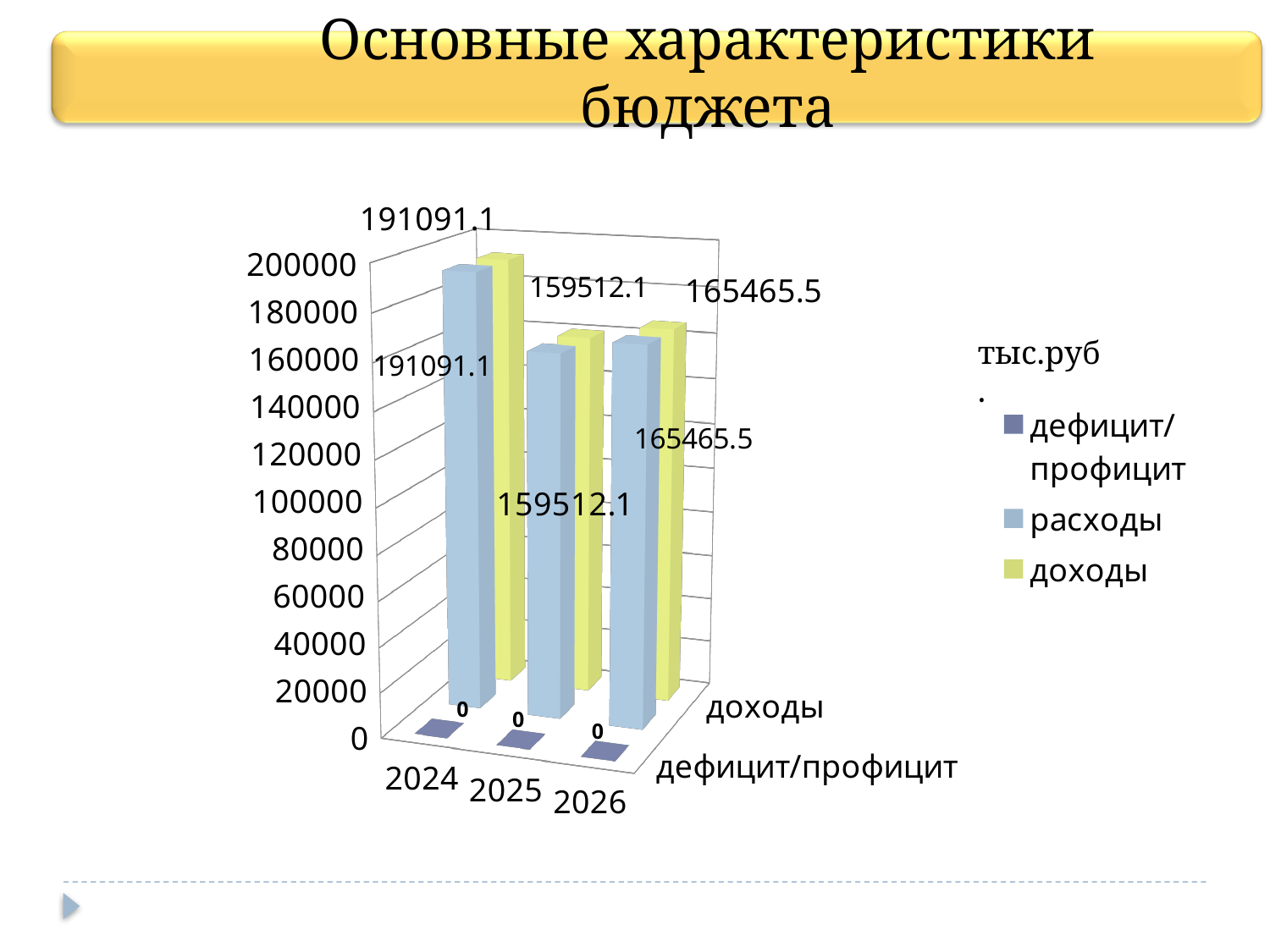
Which is larger: расходы in 2026 or расходы in 2025? расходы in 2026 What unit is indicated next to the legend? тыс.руб. What is the value of доходы for 2024? 191091.1 What type of chart is shown on the slide? bar chart What is the difference between доходы in 2024 and доходы in 2025? 31579 How many years are shown on the x axis? 3 Which year has the lowest value of расходы? 2025 What is the value of расходы for 2025? 159512.1 What is the value of дефицит/профицит for 2025? 0 How many series does the legend list? 3 What is the value of доходы for 2026? 165465.5 Which year has the highest value of доходы? 2024